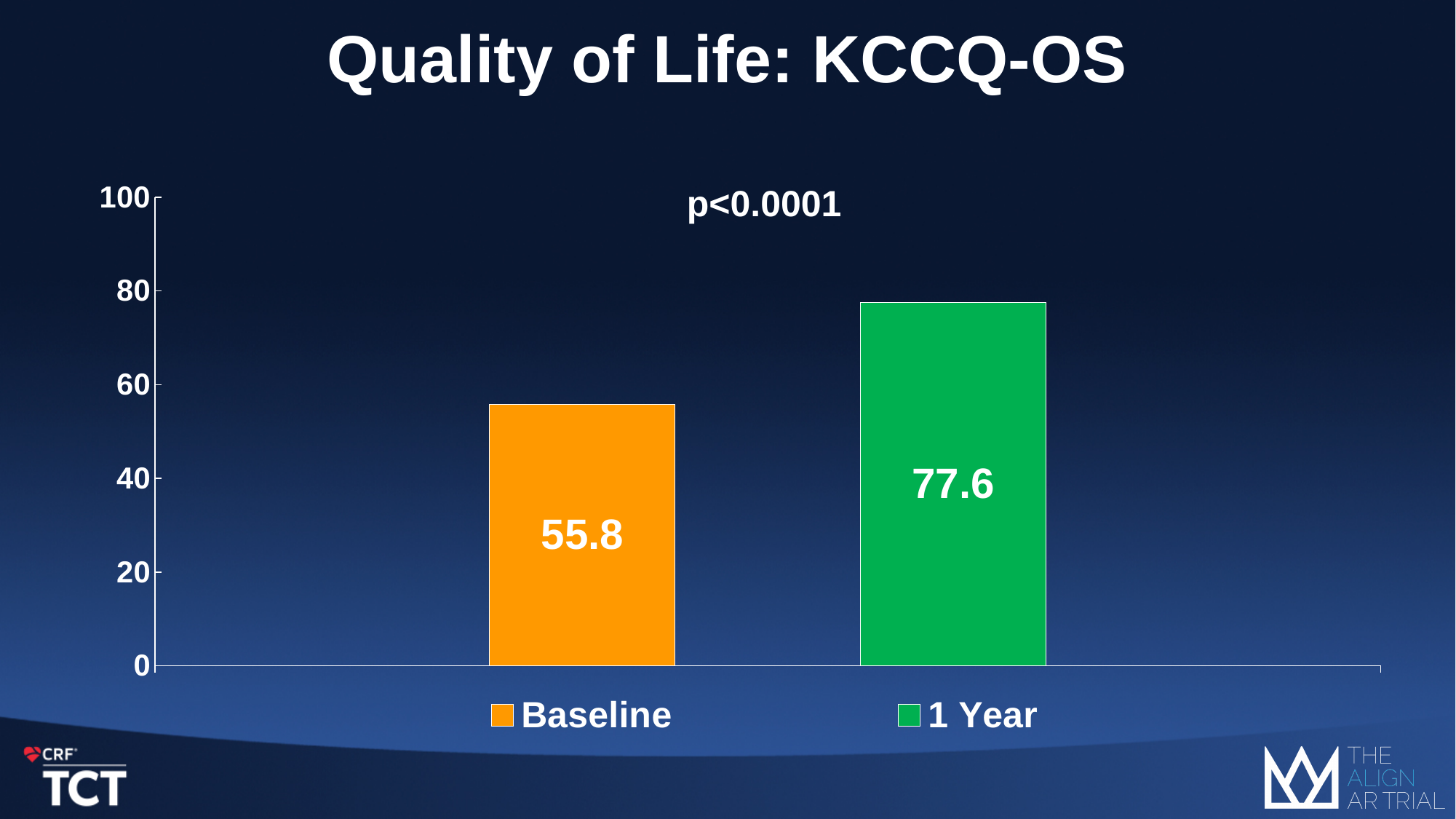
How many entries does the legend list? 2 Is the Baseline value larger or smaller than the 1 Year value? smaller Is the value for 1 Year greater or less than 80? less What is the KCCQ-OS value at 1 Year? 77.6 What p-value is shown on the chart? p<0.0001 What is the difference between the 1 Year value and the Baseline value? 21.8 Which bar is lower, Baseline or 1 Year? Baseline What is the KCCQ-OS value at Baseline? 55.8 What kind of chart is shown on the slide? bar chart Which bar is higher, Baseline or 1 Year? 1 Year How many bars are plotted on the chart? 2 Is the value for Baseline greater or less than 40? greater